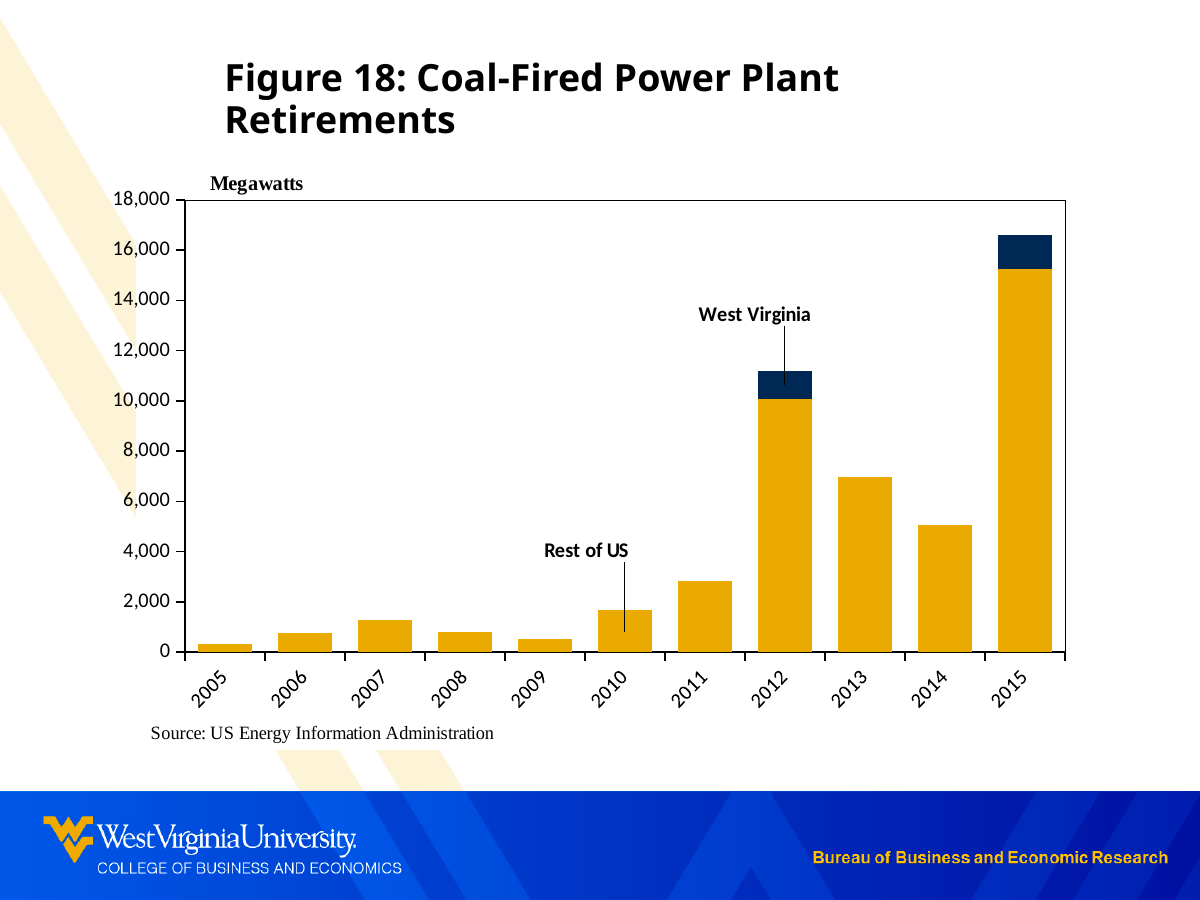
How many data series does the chart show? 2 Is the total value for 2015 greater or less than 16,000 megawatts? greater What unit is shown on the y axis of the chart? Megawatts Which year has the highest total coal-fired power plant retirements? 2015 Is the total value for 2013 greater or less than 8,000 megawatts? less Is the Rest of US value for 2012 greater or less than 8,000 megawatts? greater Which year has the lowest total coal-fired power plant retirements? 2005 Which series is shown in dark blue at the top of the 2012 and 2015 bars? West Virginia Do total retirements rise or fall from 2012 to 2014? Fall Which year has the larger total retirements, 2013 or 2014? 2013 What kind of chart is shown on the slide? Stacked bar chart How many years are shown on the x axis of the chart? 11